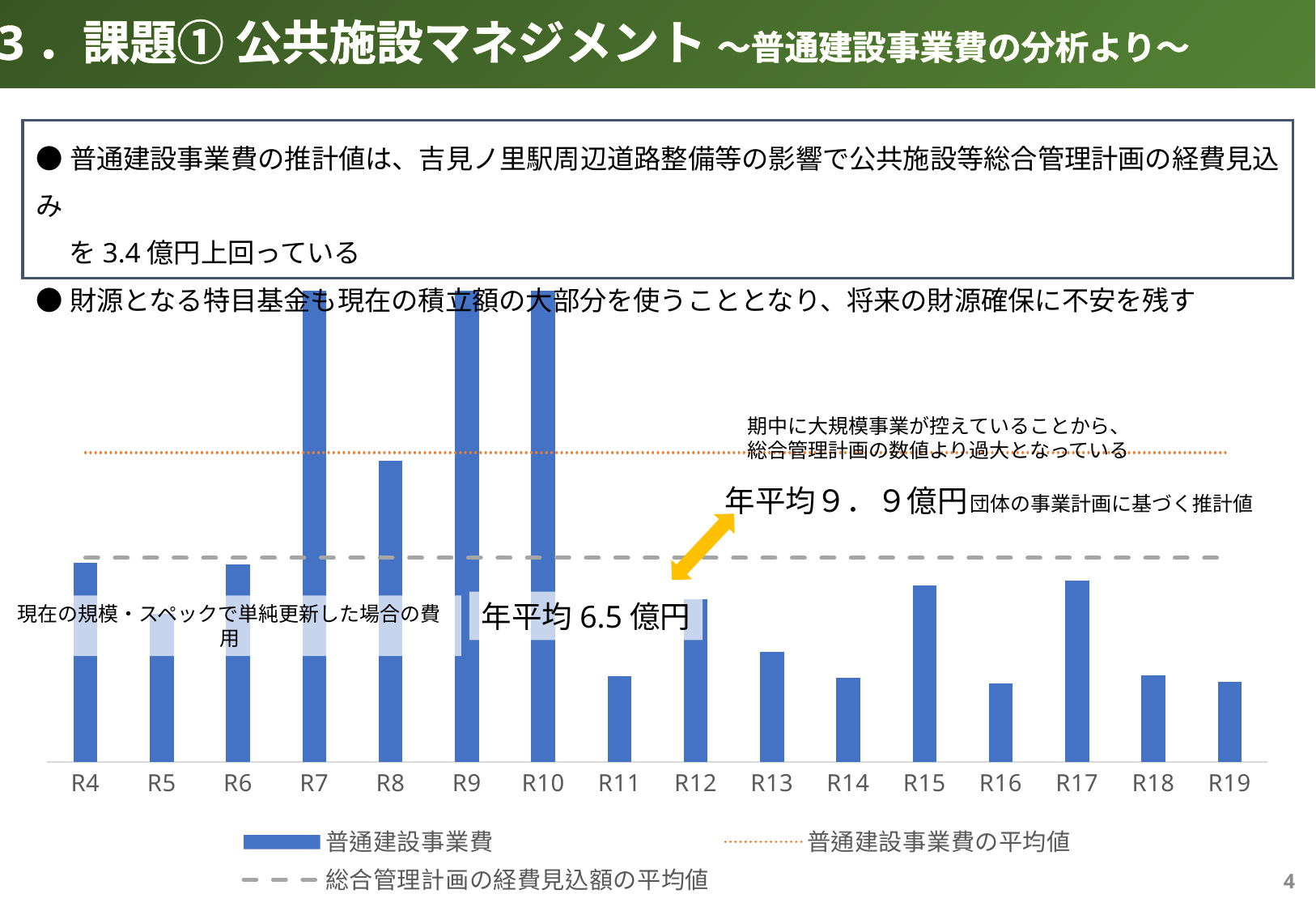
Which bar is taller, R4 or R11? R4 What is the annual average of 普通建設事業費 shown on the chart? 9.9億円 What kind of chart is shown on the slide? combination bar and line chart Which bar is taller, R8 or R15? R8 Which bar is taller, R17 or R13? R17 How many fiscal-year categories are shown on the x axis of the chart? 16 Do the bar values rise or fall from R10 to R11? fall How many series does the chart legend list? 3 Which legend entry is drawn as a gray dashed line? 総合管理計画の経費見込額の平均値 What is the annual average of 総合管理計画の経費見込額 shown on the chart? 6.5億円 What is the first category label on the x axis of the chart? R4 By how much does the annual average of 普通建設事業費 (9.9億円) exceed the annual average of 総合管理計画の経費見込額 (6.5億円)? 3.4億円